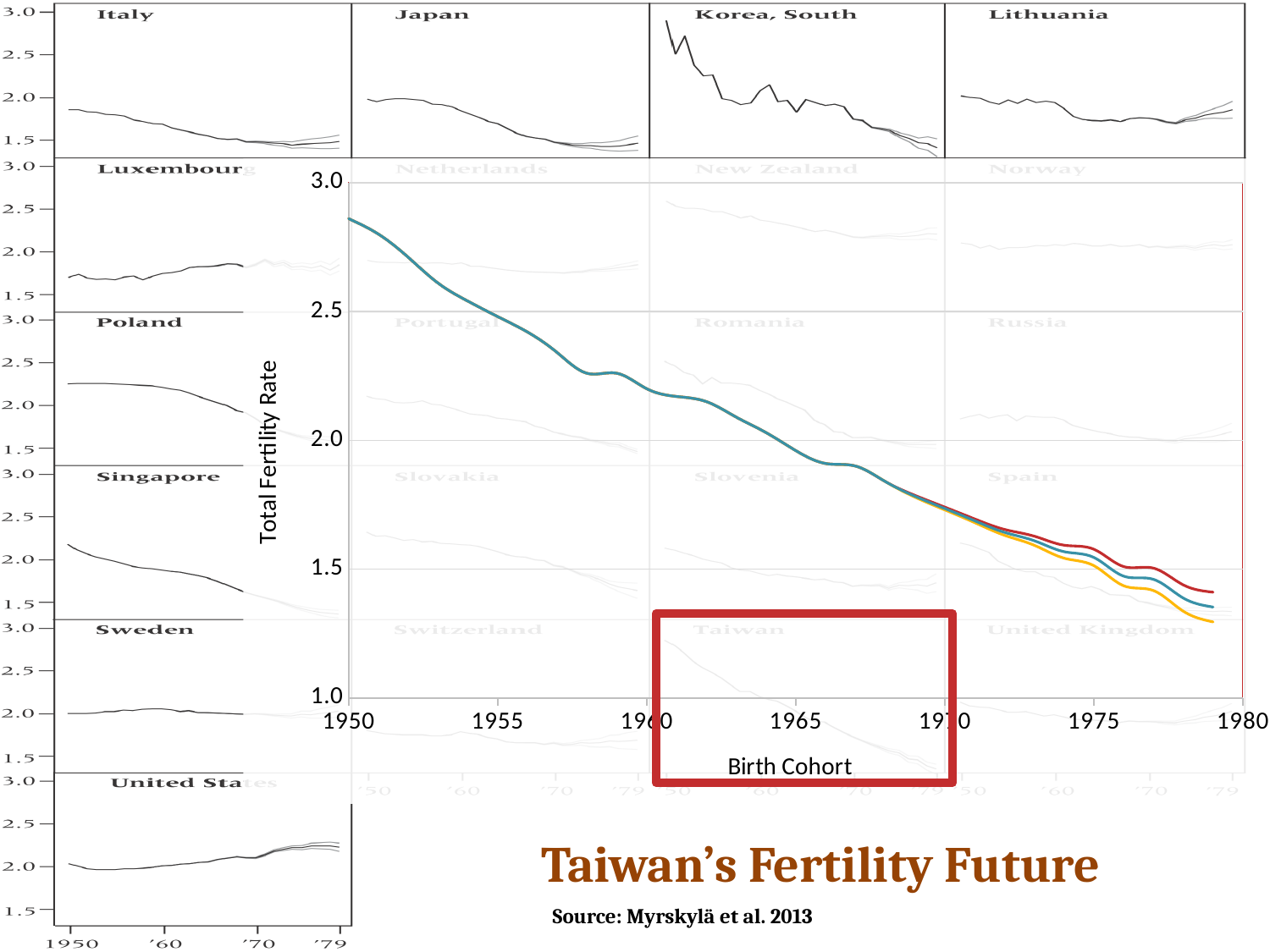
Comparing the small 'Korea, South' and 'Italy' panels, which country has the higher total fertility rate for the 1950 birth cohort? Korea, South On the large Taiwan chart, is the yellow line's value for the 1979 birth cohort greater or less than 1.5? less What is the label of the y axis on the large chart? Total Fertility Rate On the large Taiwan chart, is the total fertility rate for the 1960 birth cohort greater or less than 2.0? greater On the large Taiwan chart, is the total fertility rate for the 1970 birth cohort greater or less than 2.0? less On the large Taiwan chart, does the total fertility rate rise or fall from the 1950 birth cohort to the 1979 birth cohort? fall What is the title printed below the large chart? Taiwan's Fertility Future On the large Taiwan chart, which coloured line is highest at the 1979 birth cohort: red, blue or yellow? red How many coloured lines are plotted on the large Taiwan chart? 3 What kind of chart is the large highlighted chart on the slide? line chart